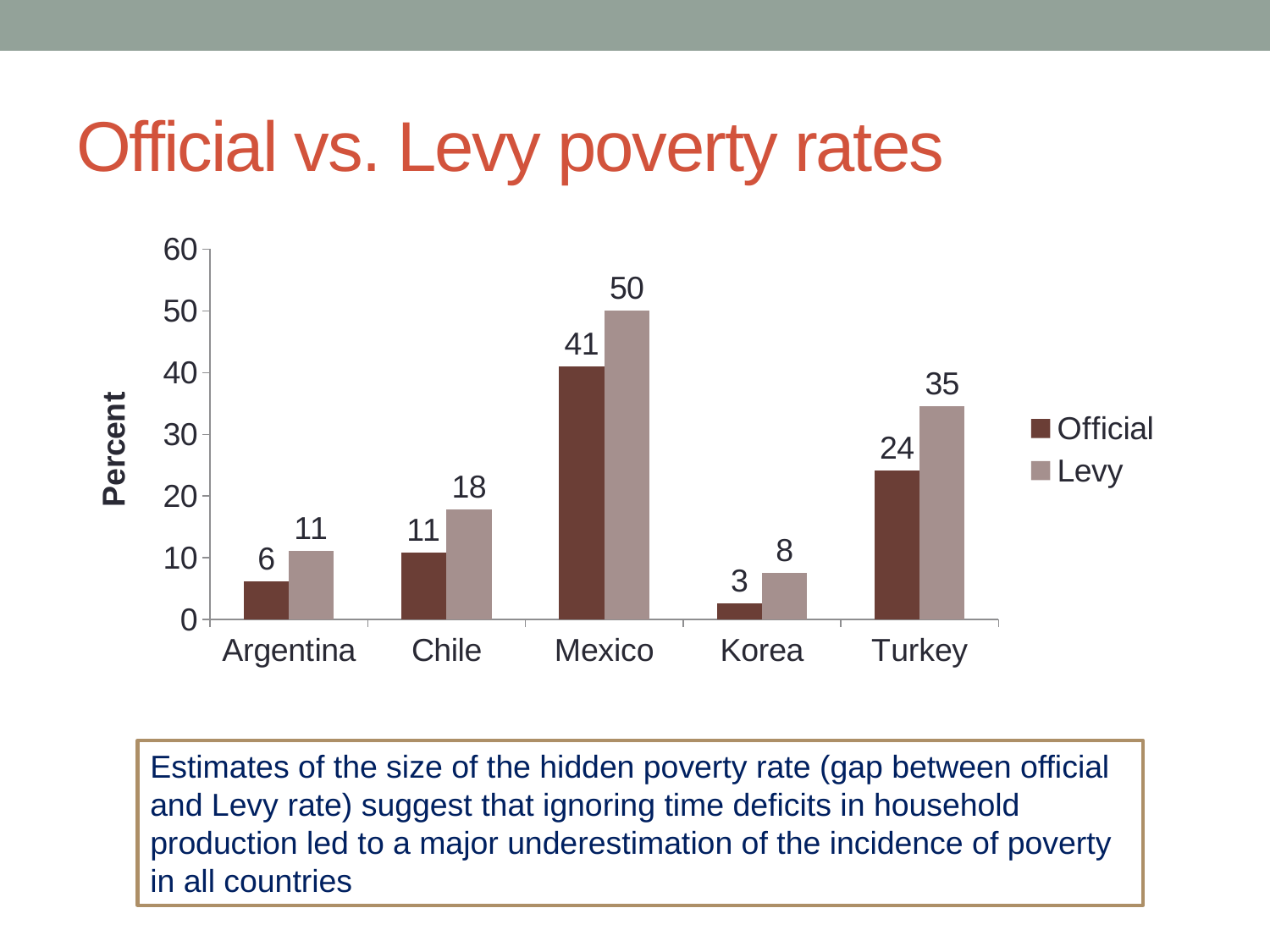
What is the difference between the Levy and Official poverty rates for Mexico? 9 What is the Levy poverty rate for Turkey? 35 How many series does the legend list? 2 How many countries are shown on the x axis? 5 Which is larger, the Official rate for Chile or the Official rate for Argentina? Chile What is the Official poverty rate for Mexico? 41 What kind of chart is shown on the slide? Bar chart What is the Levy poverty rate for Chile? 18 What is the difference between the Levy and Official poverty rates for Turkey? 11 Which country has the lowest Official poverty rate? Korea Which country has the highest Levy poverty rate? Mexico Is the Levy poverty rate for Korea greater or less than 10? less